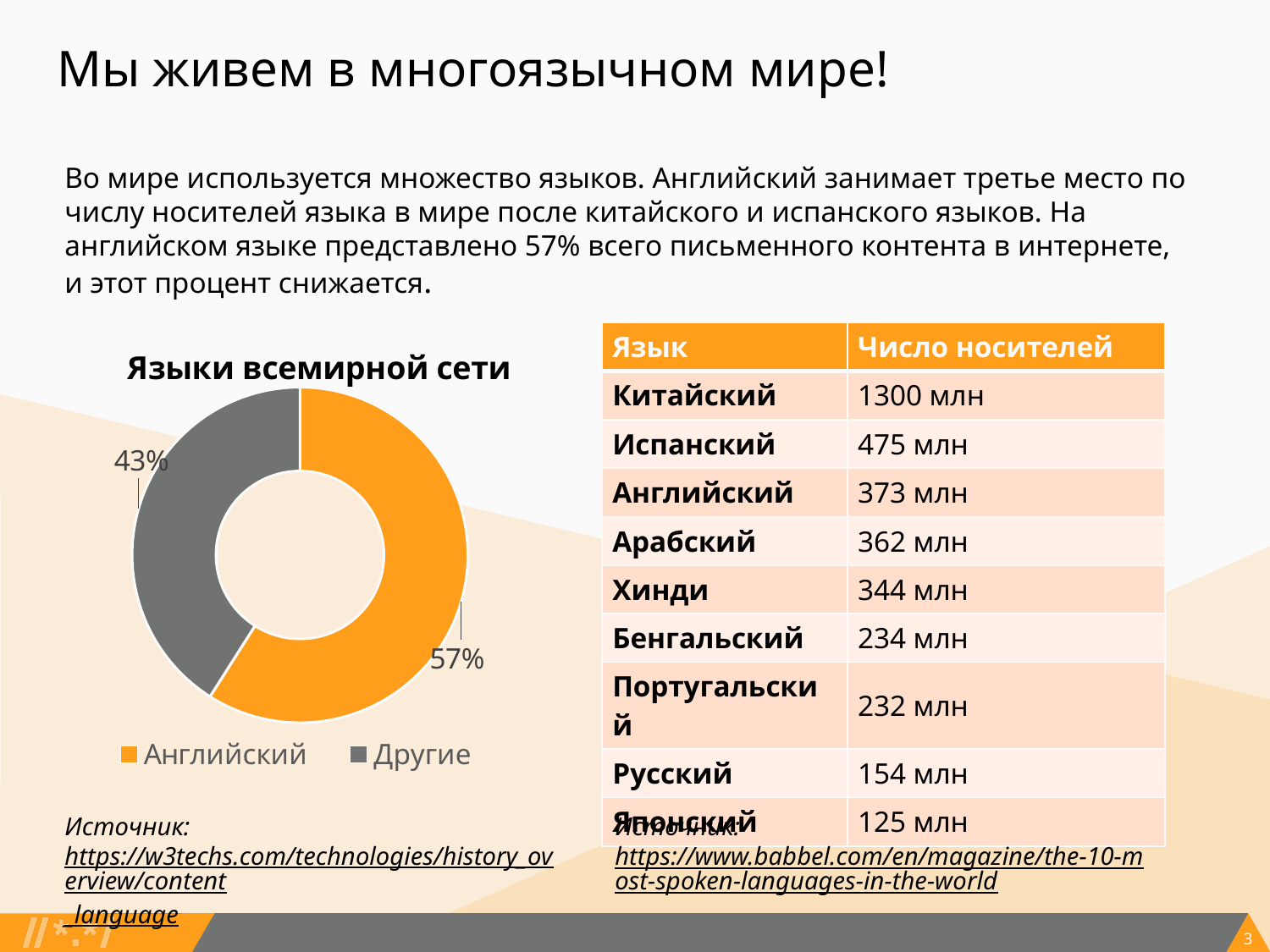
What is the title of the chart on the slide? Языки всемирной сети What share of the chart does Английский take? 57% How many slices does the chart have? 2 What is the total of the two slices shown in the chart? 100% Which is larger in the chart, Английский or Другие? Английский Which slice of the chart is the largest? Английский How many entries does the chart legend list? 2 What share of the chart does Другие take? 43% What is the difference in percentage points between Английский and Другие in the chart? 14 What kind of chart is shown on the slide? doughnut chart Which slice of the chart is the smallest? Другие What colour is the Английский slice in the chart? orange